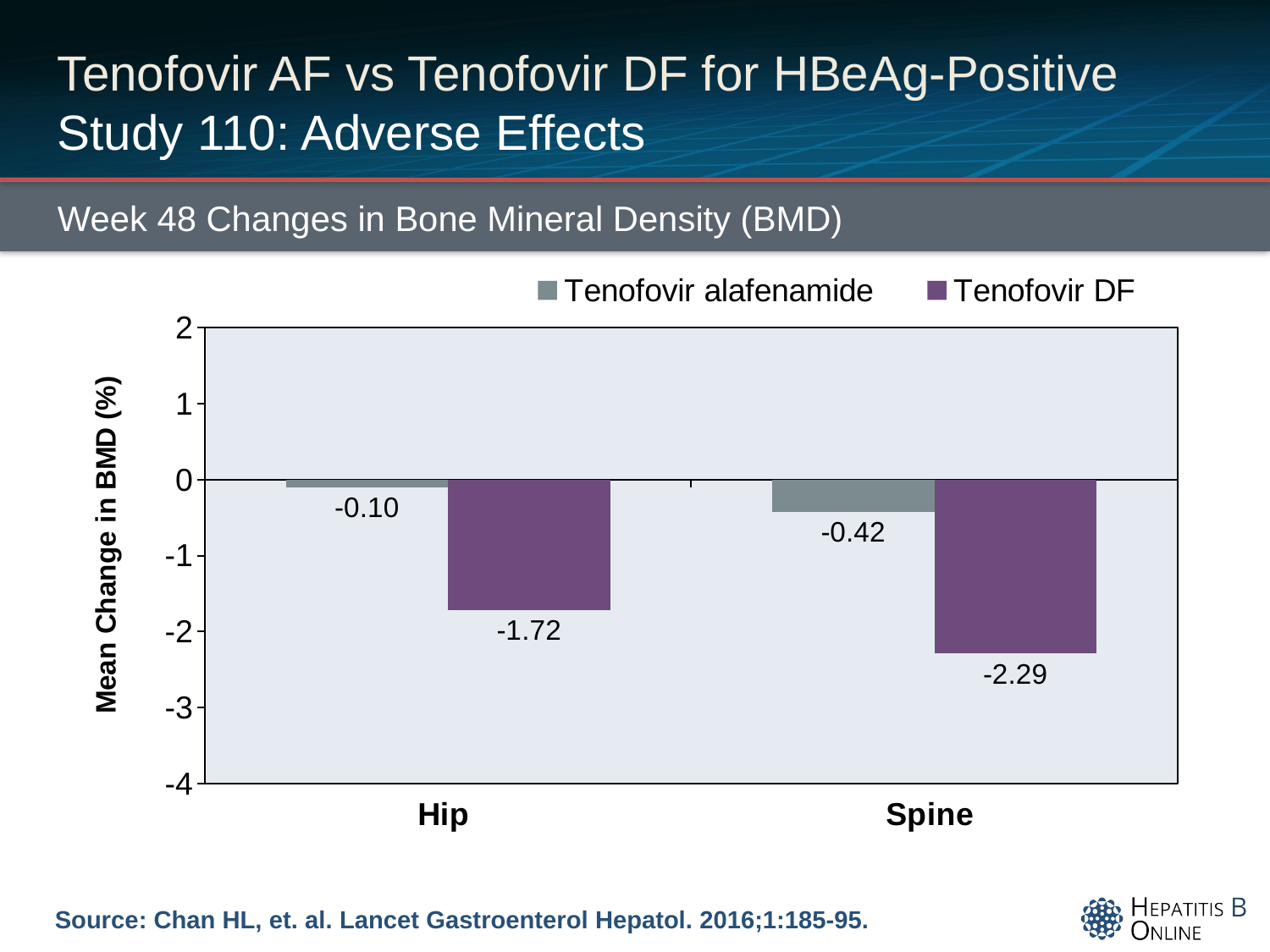
Which category shows the lowest (most negative) value for Tenofovir DF? Spine What is the difference between the Tenofovir DF and Tenofovir alafenamide values at the Hip? 1.62 What is the label of the y axis? Mean Change in BMD (%) What is the mean change in BMD for Tenofovir DF at the Hip? -1.72 How many categories are shown on the x axis? 2 What is the mean change in BMD for Tenofovir alafenamide at the Hip? -0.10 What kind of chart is shown on the slide? Bar chart What is the difference between the Tenofovir DF and Tenofovir alafenamide values at the Spine? 1.87 Which series has the larger decrease in BMD at the Spine? Tenofovir DF What is the mean change in BMD for Tenofovir DF at the Spine? -2.29 How many series does the legend list? 2 What is the mean change in BMD for Tenofovir alafenamide at the Spine? -0.42